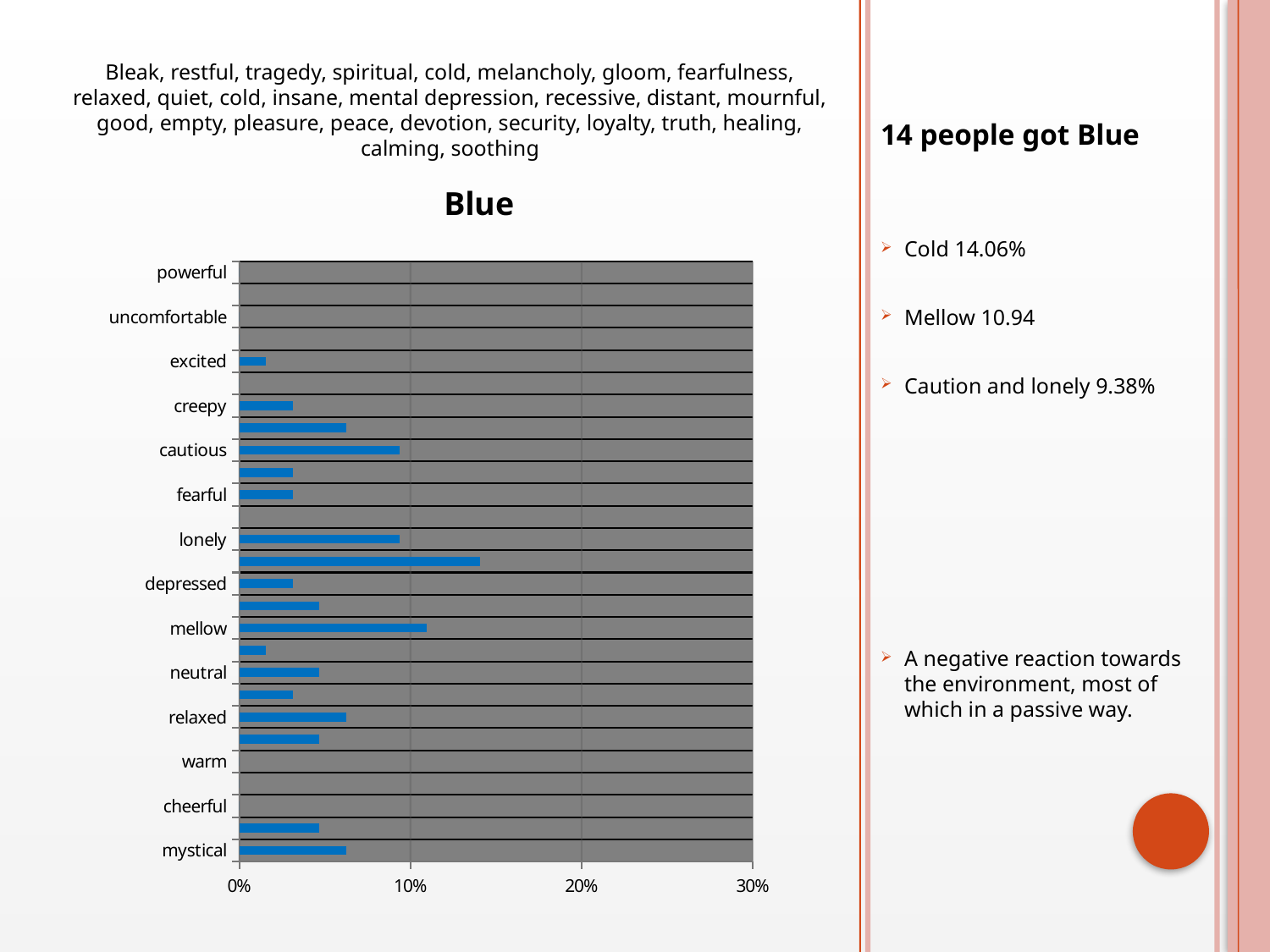
What is the highest value shown on the x axis of the chart? 30% Is the value for mystical greater or less than 10%? less Is the value for excited greater or less than 10%? less What is the title of the chart? Blue Is the value for creepy greater or less than 10%? less What kind of chart is shown on the slide? bar chart Which has the larger value, relaxed or creepy? relaxed Which has the larger value, mellow or excited? mellow Which has the larger value, lonely or fearful? lonely